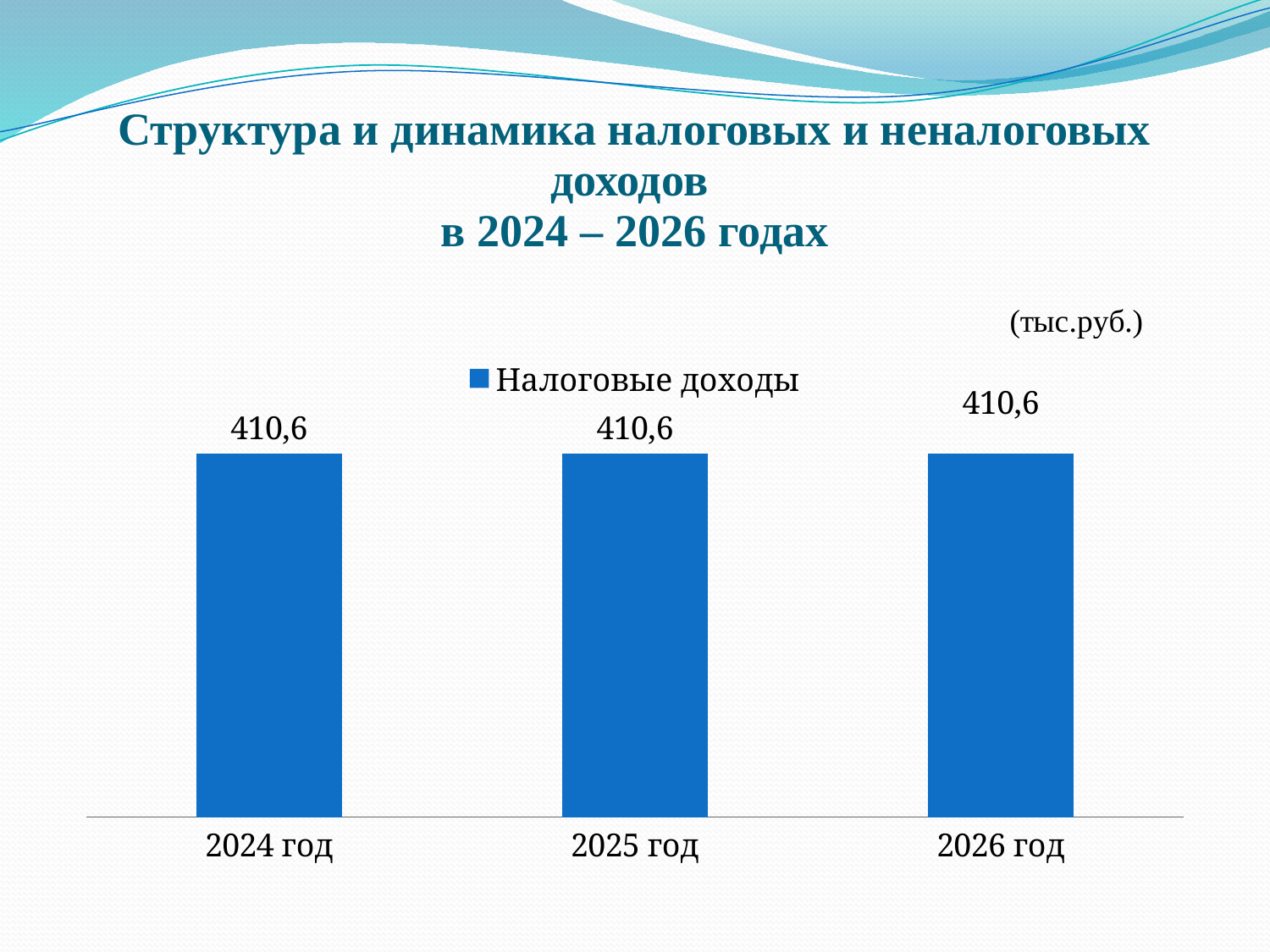
How many categories are shown on the x axis? 3 Do the values rise, fall or stay the same from 2024 год to 2026 год? stay the same What is the value for 2024 год? 410,6 What is the difference between the values for 2024 год and 2026 год? 0 What unit is indicated for the values on the chart? тыс.руб. What kind of chart is shown on the slide? bar chart What is the value for 2025 год? 410,6 What is the value for 2026 год? 410,6 How many series does the legend list? 1 What is the name of the series in the legend? Налоговые доходы